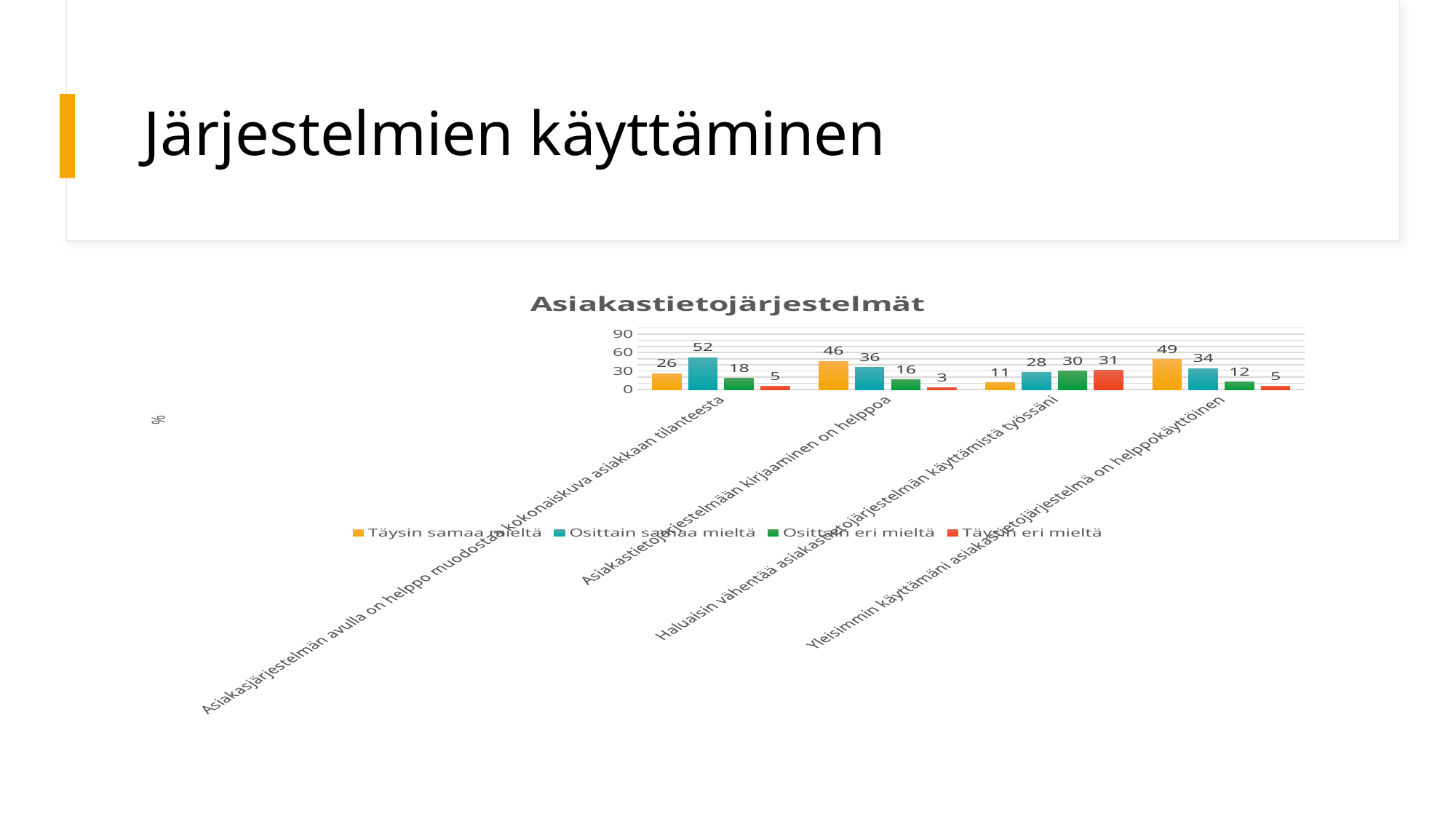
What is the value for "Täysin eri mieltä" in the category "Haluaisin vähentää asiakastietojärjestelmän käyttämistä työssäni"? 31 What is the value for "Täysin samaa mieltä" in the category "Asiakastietojärjestelmään kirjaaminen on helppoa"? 46 Which category has the lowest value for "Täysin eri mieltä"? Asiakastietojärjestelmään kirjaaminen on helppoa What kind of chart is shown on the slide? Bar chart In the category "Haluaisin vähentää asiakastietojärjestelmän käyttämistä työssäni", which is larger: "Täysin samaa mieltä" or "Osittain eri mieltä"? Osittain eri mieltä What is the title of the chart? Asiakastietojärjestelmät What is the value for "Osittain samaa mieltä" in the category "Asiakasjärjestelmän avulla on helppo muodostaa kokonaiskuva asiakkaan tilanteesta"? 52 What is the value for "Osittain eri mieltä" in the category "Yleisimmin käyttämäni asiakastietojärjestelmä on helppokäyttöinen"? 12 How many series does the legend list? 4 How many categories are shown on the x axis of the chart? 4 Which category has the highest value for "Täysin samaa mieltä"? Yleisimmin käyttämäni asiakastietojärjestelmä on helppokäyttöinen What is the difference between the "Osittain samaa mieltä" and "Täysin samaa mieltä" values in the category "Asiakasjärjestelmän avulla on helppo muodostaa kokonaiskuva asiakkaan tilanteesta"? 26